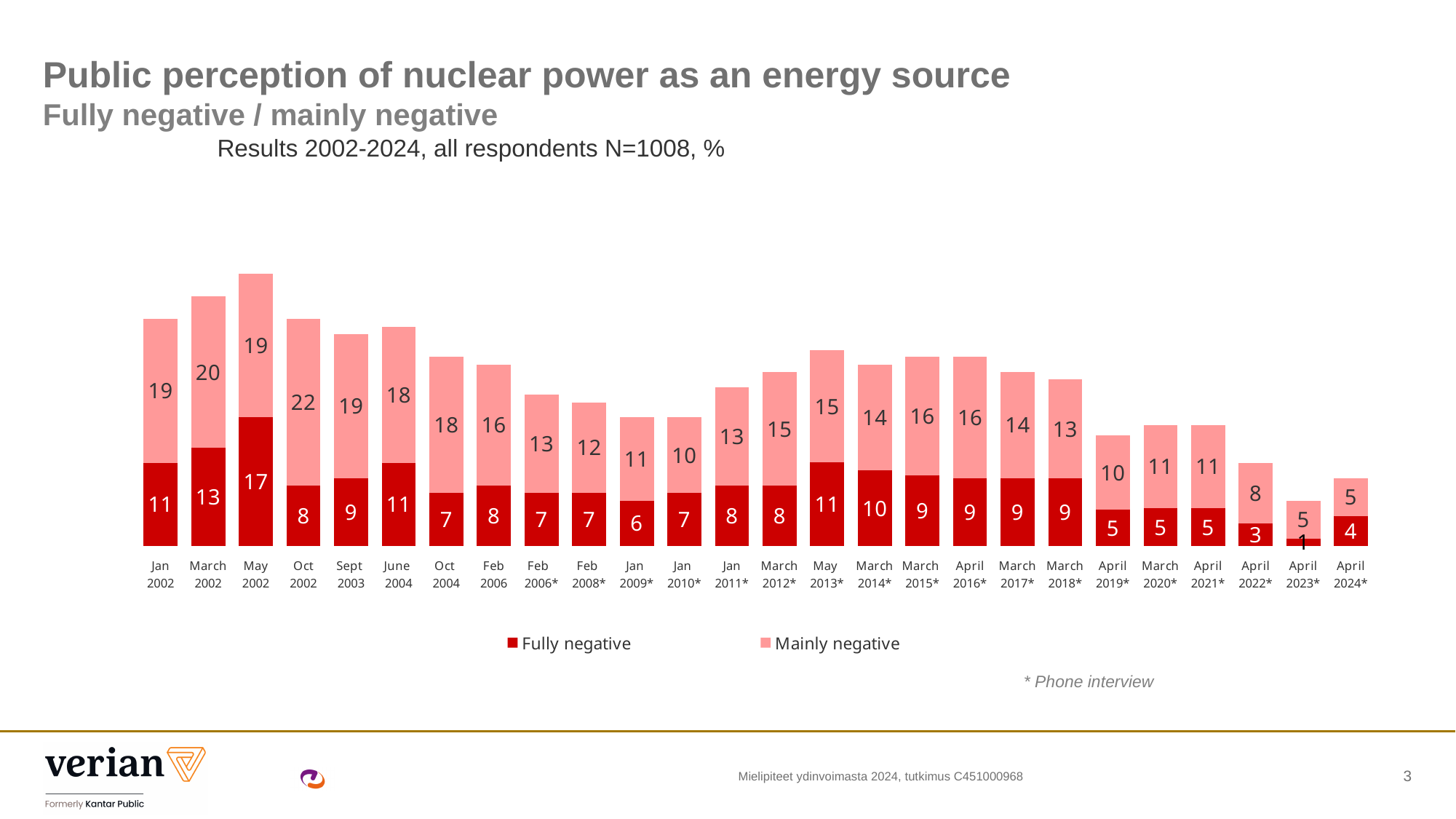
How many series does the legend list? 2 What is the total of the stacked bar for April 2024*? 9 Which time point has the lowest 'Fully negative' value? April 2023* What kind of chart is shown on the slide? Stacked bar chart What is the 'Fully negative' value for May 2002? 17 Which time point has the highest 'Mainly negative' value? Oct 2002 How many time points (bars) are plotted on the chart? 26 Which has the larger 'Fully negative' value, March 2014* or March 2015*? March 2014* Which time point has the highest 'Fully negative' value? May 2002 What is the 'Mainly negative' value for Oct 2002? 22 What is the total of the stacked bar for May 2002? 36 What is the difference between the 'Mainly negative' value for Jan 2002 and for April 2024*? 14